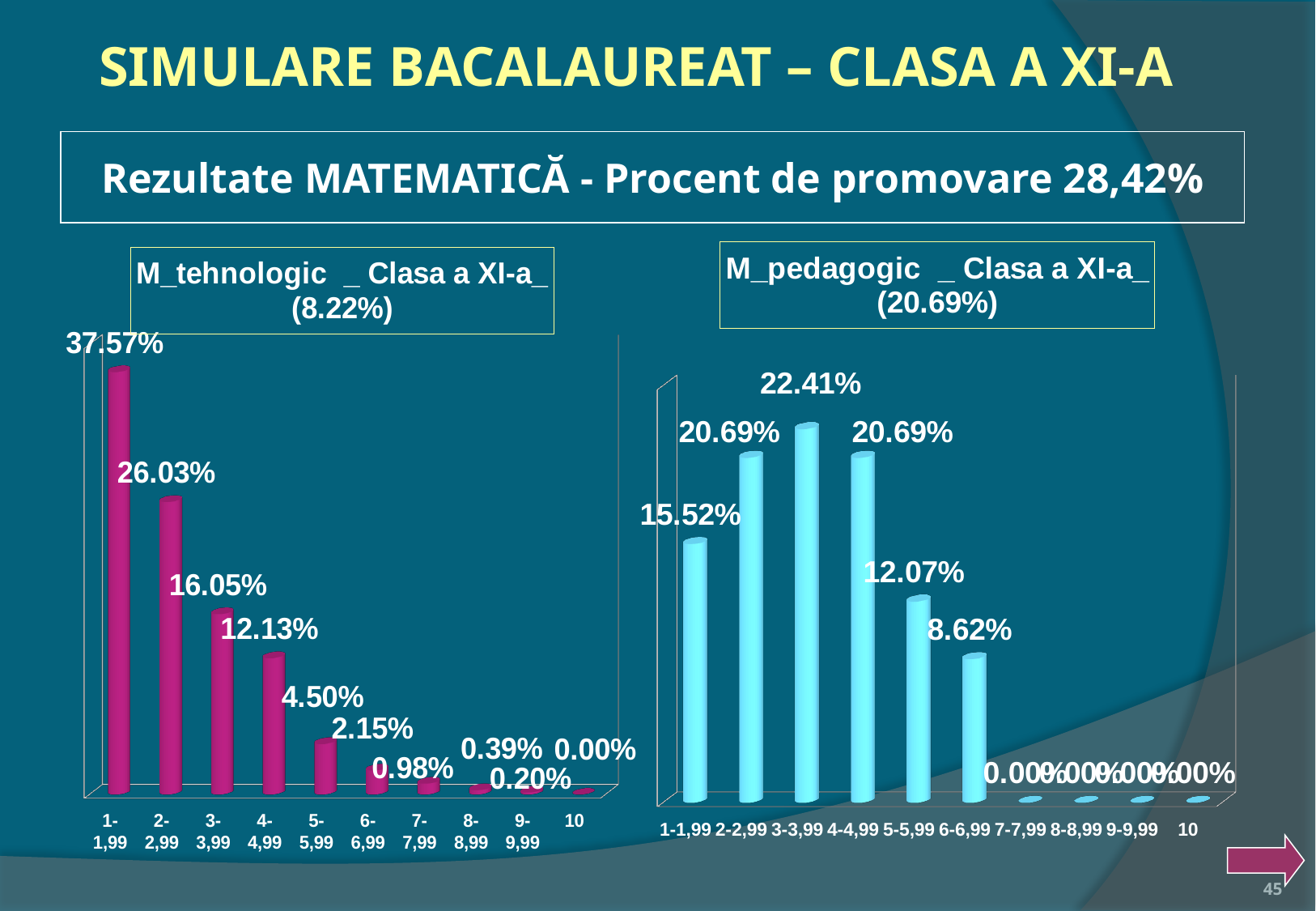
How many categories are shown on the x axis of the M_pedagogic chart? 10 In the M_pedagogic chart, what is the value for the 3-3,99 category? 22.41% In the M_tehnologic chart, which category has the lowest value? 10 What kind of chart is the M_tehnologic chart? Bar chart In the M_tehnologic chart, do the values rise or fall from left to right along the x axis? Fall In the M_pedagogic chart, what is the difference between the values for 3-3,99 and 5-5,99? 10.34% In the M_tehnologic chart, what is the difference between the values for 1-1,99 and 2-2,99? 11.54% In the M_pedagogic chart, what is the value for the 6-6,99 category? 8.62% In the M_tehnologic chart, what is the value for the 1-1,99 category? 37.57% In the M_tehnologic chart, what is the value for the 4-4,99 category? 12.13% In the M_pedagogic chart, which category has the highest value? 3-3,99 Which is larger: the value for 2-2,99 in the M_tehnologic chart or the value for 2-2,99 in the M_pedagogic chart? M_tehnologic (26.03%)